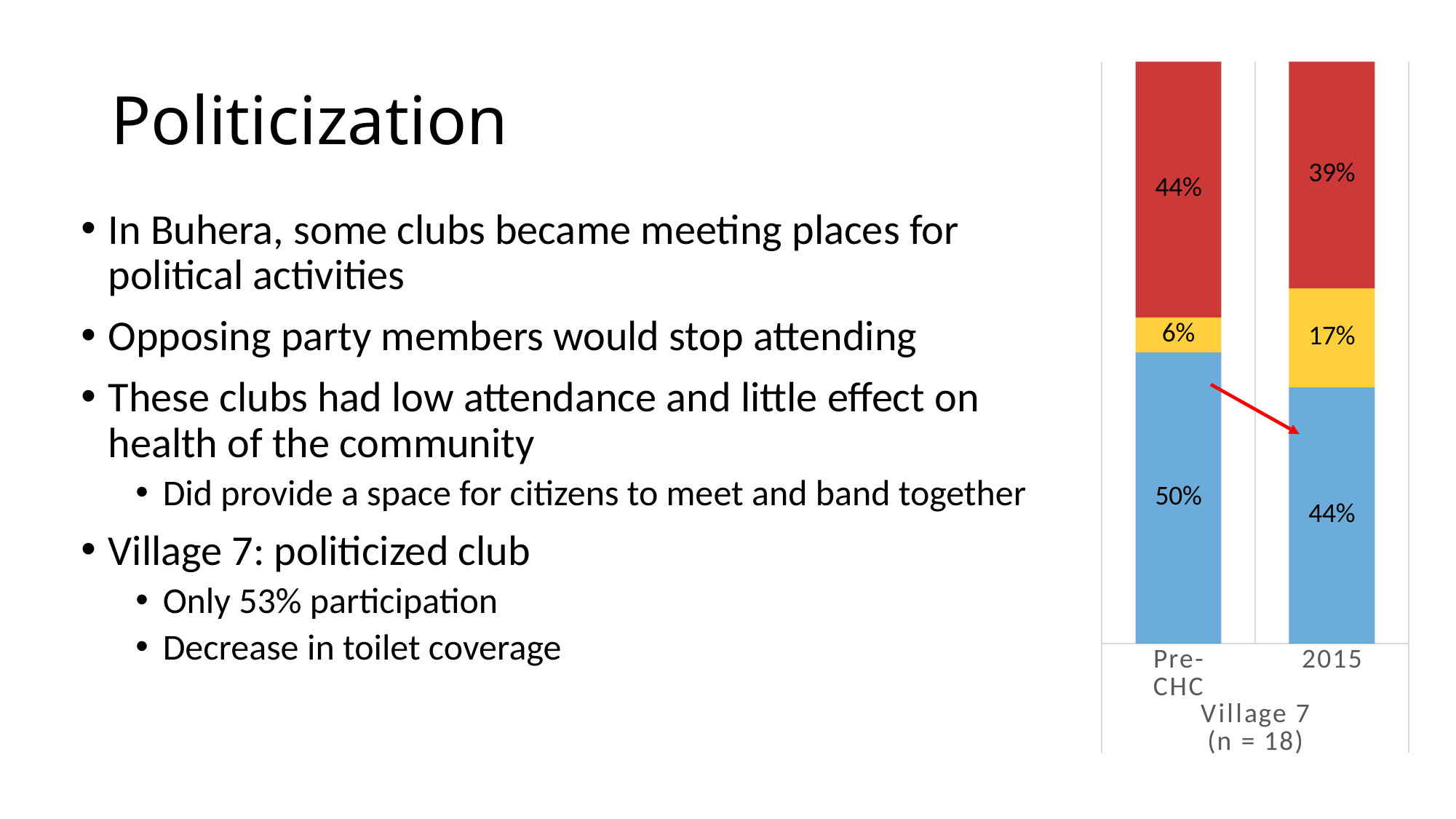
Which segment is the largest in the Pre-CHC bar? The blue segment (50%) What is the value of the yellow segment of the Pre-CHC bar? 6% What is the value of the blue segment of the Pre-CHC bar? 50% How many bars are shown in the chart? 2 By how many percentage points does the yellow segment change from Pre-CHC to 2015? 11 percentage points What kind of chart is shown on the slide? Stacked bar chart By how many percentage points does the blue segment change from Pre-CHC to 2015? 6 percentage points What is the value of the yellow segment of the 2015 bar? 17% What is the value of the red segment of the 2015 bar? 39% Does the blue segment rise or fall from Pre-CHC to 2015? Fall What group label appears below the x-axis categories of the chart? Village 7 (n = 18) Is the red segment larger in the Pre-CHC bar or the 2015 bar? Pre-CHC